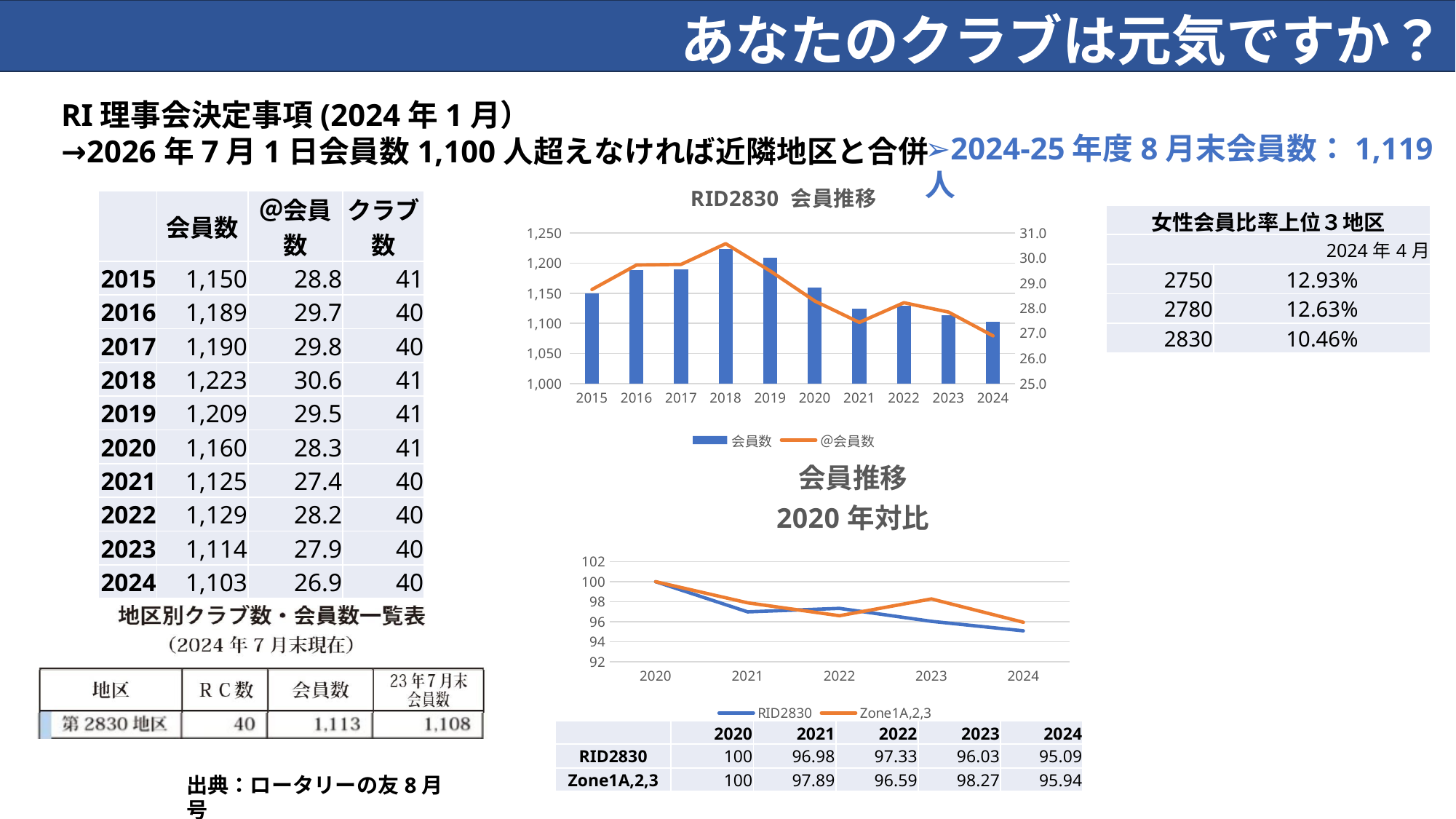
In the 会員推移 2020年対比 chart, what kind of chart is used? line chart In the RID2830 会員推移 chart, which year has the tallest 会員数 bar? 2018 In the RID2830 会員推移 chart, do the 会員数 bars rise or fall from 2018 to 2024? fall In the 会員推移 2020年対比 chart, which series is higher in 2023, RID2830 or Zone1A,2,3? Zone1A,2,3 In the RID2830 会員推移 chart, how many years are shown on the x axis? 10 In the RID2830 会員推移 chart, what is the 会員数 value for 2018? 1,223 In the RID2830 会員推移 chart, how many series does the legend list? 2 In the 会員推移 2020年対比 chart, what is the RID2830 value for 2024? 95.09 In the RID2830 会員推移 chart, which year has the shortest 会員数 bar? 2024 In the RID2830 会員推移 chart, is the 会員数 bar for 2021 greater or less than 1,100? greater In the 会員推移 2020年対比 chart, what is the difference between Zone1A,2,3 and RID2830 in 2024? 0.85 In the RID2830 会員推移 chart, what kind of chart is used? bar chart with a line